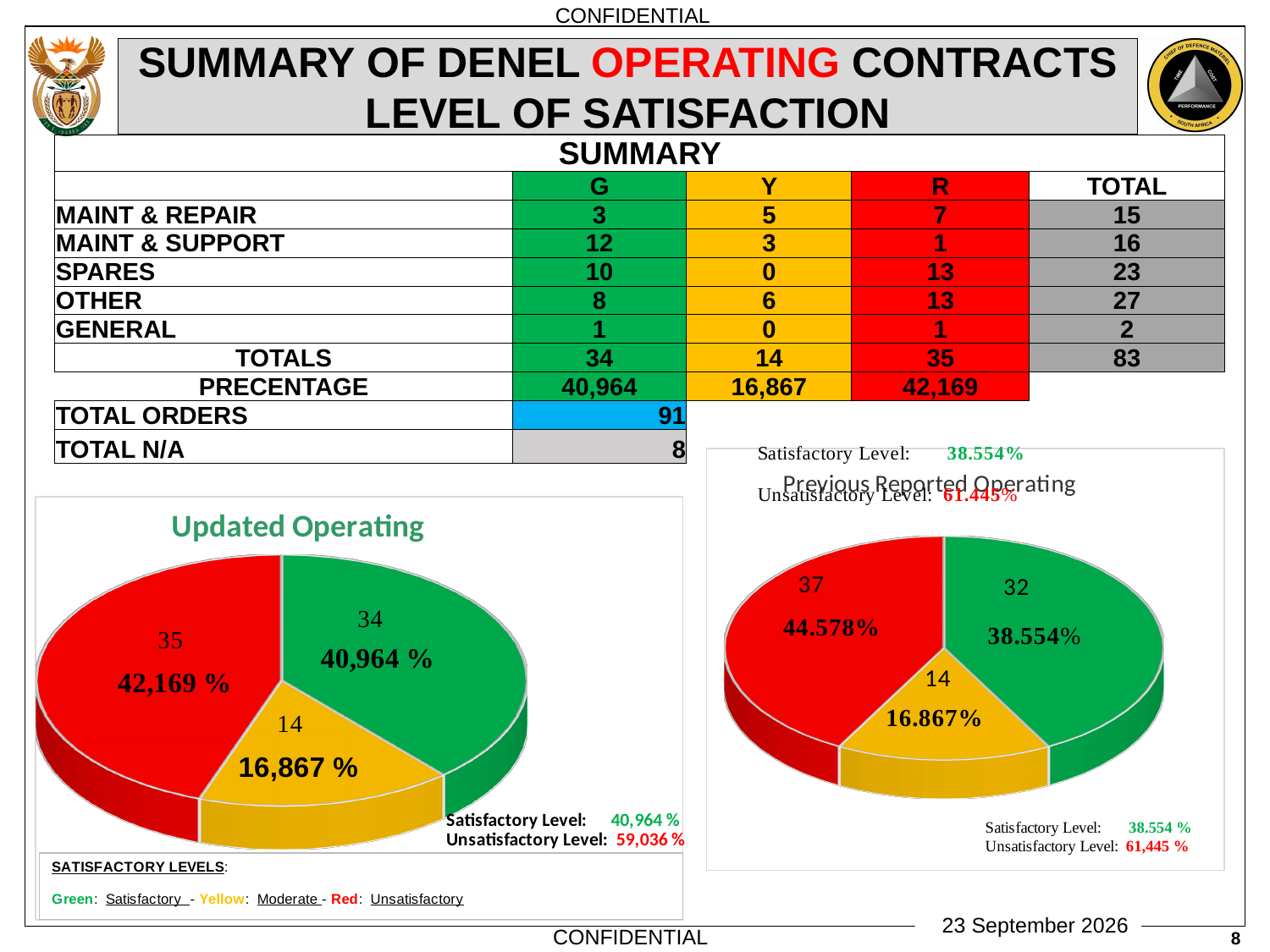
In the "Updated Operating" pie chart, what percentage is shown on the yellow slice? 16,867 % In the "Updated Operating" pie chart, what percentage is shown on the red slice? 42,169 % In the "Updated Operating" pie chart, what value is shown on the green slice? 34 What kind of chart is the "Updated Operating" chart on the left? pie chart In the "Previous Reported Operating" pie chart, what is the difference between the red slice value and the green slice value? 5 In the "Updated Operating" pie chart, which slice has the smallest value? yellow (14) What is the title of the pie chart on the left of the slide? Updated Operating Comparing the green slices, is the value in the "Updated Operating" chart or the "Previous Reported Operating" chart larger? Updated Operating (34 vs 32) In the "Previous Reported Operating" pie chart, what value is shown on the red slice? 37 How many slices does the "Updated Operating" pie chart have? 3 In the "Previous Reported Operating" pie chart, which slice has the largest value? red (37) In the "Previous Reported Operating" pie chart, what percentage is shown on the green slice? 38.554%